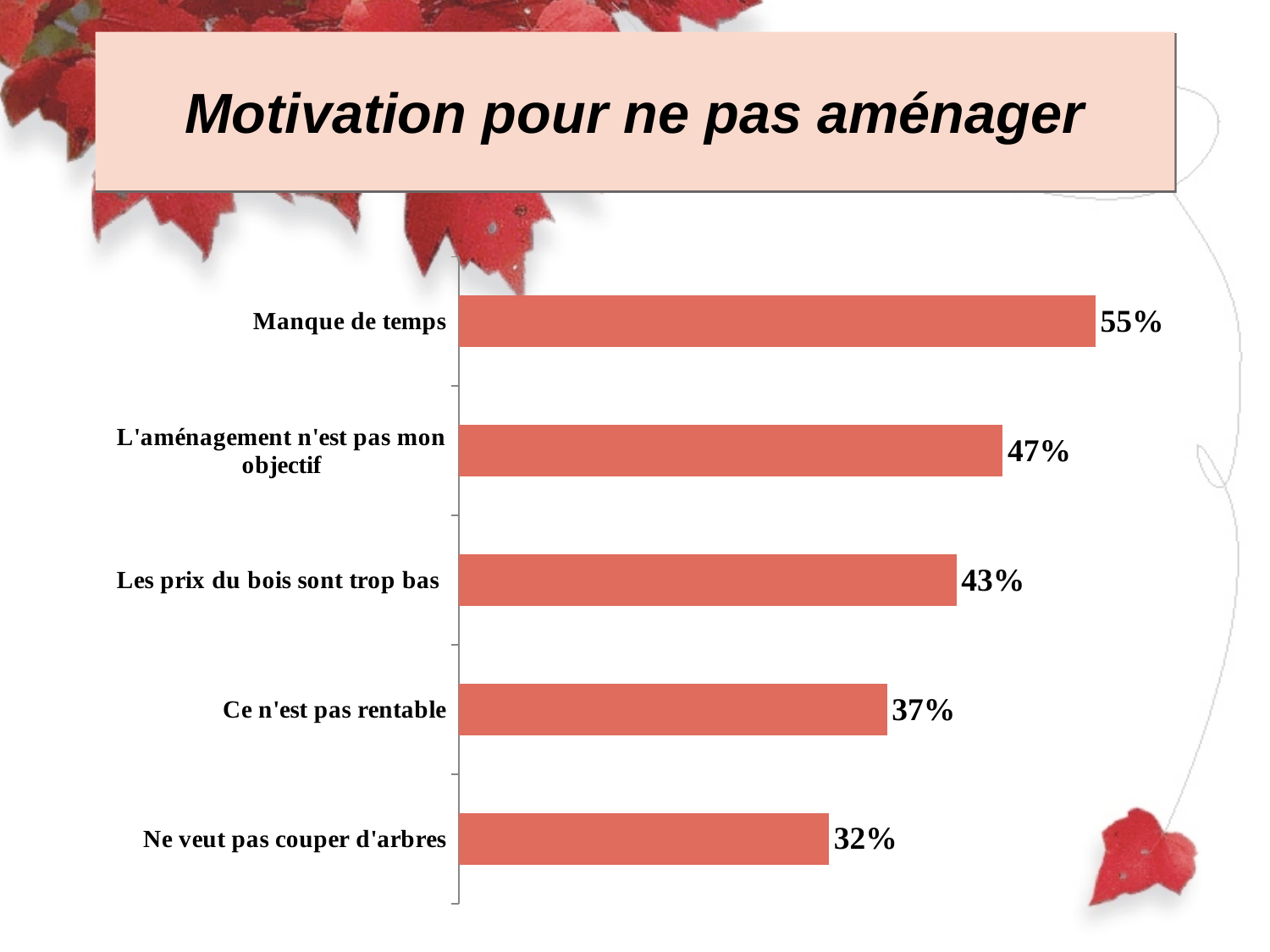
How many categories are shown in the chart? 5 Which category has the highest value? Manque de temps Which is larger: the value for "Ce n'est pas rentable" or the value for "Les prix du bois sont trop bas"? Les prix du bois sont trop bas What is the value for "Manque de temps"? 55% Which category has the lowest value? Ne veut pas couper d'arbres What kind of chart is shown on the slide? Bar chart What is the value for "Ne veut pas couper d'arbres"? 32% What is the difference between the values for "Les prix du bois sont trop bas" and "Ne veut pas couper d'arbres"? 11% What is the title of the slide? Motivation pour ne pas aménager What is the difference between the values for "Manque de temps" and "L'aménagement n'est pas mon objectif"? 8% What is the value for "Ce n'est pas rentable"? 37% What is the value for "Les prix du bois sont trop bas"? 43%